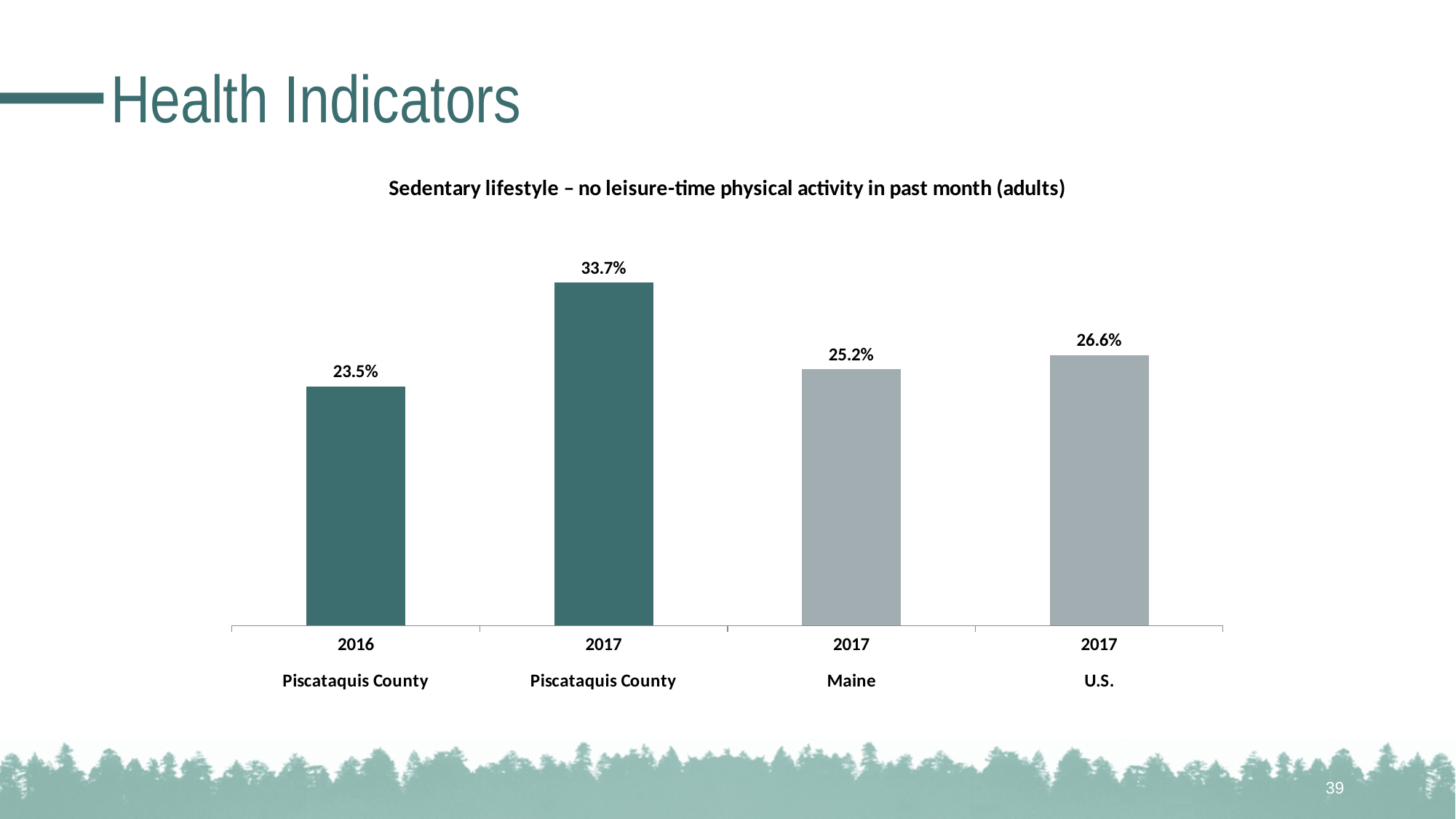
What is the value for Maine in 2017? 25.2% How many bars are shown in the chart? 4 Which bar has the lowest value? Piscataquis County 2016 What is the title of the chart? Sedentary lifestyle – no leisure-time physical activity in past month (adults) What is the difference between the Piscataquis County 2017 value and the Maine 2017 value? 8.5% What kind of chart is shown on the slide? Bar chart Which is larger, the value for Maine in 2017 or the value for the U.S. in 2017? U.S. in 2017 Which bar has the highest value? Piscataquis County 2017 What is the difference between the Piscataquis County 2017 value and the Piscataquis County 2016 value? 10.2% What is the value for Piscataquis County in 2016? 23.5% What is the value for the U.S. in 2017? 26.6% What is the value for Piscataquis County in 2017? 33.7%